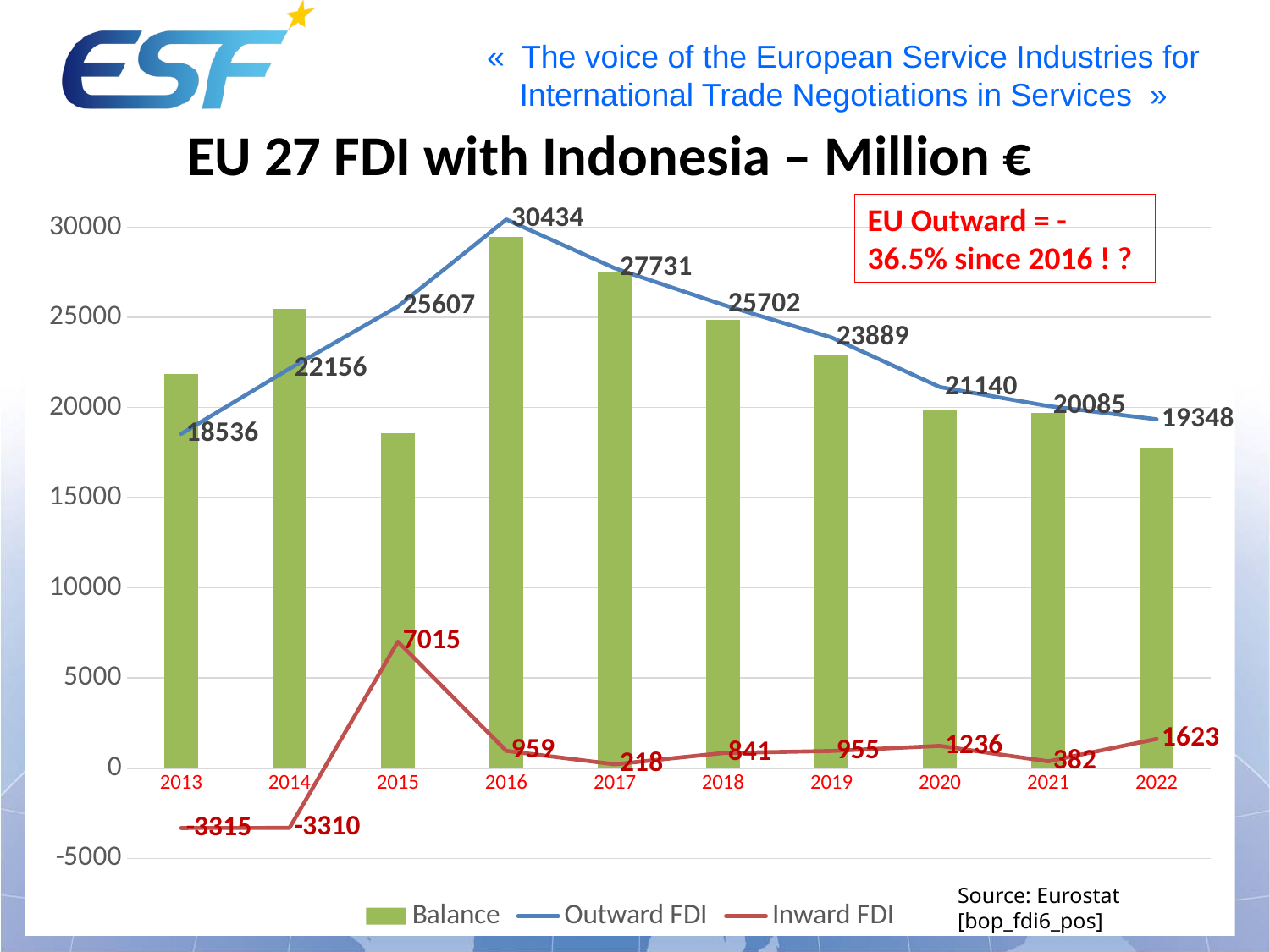
Is the Balance bar for 2016 greater or less than 25000? greater What is the difference between Outward FDI in 2016 and in 2022? 11086 How many series does the legend list? 3 How many years are shown on the x axis? 10 What is the Inward FDI value for 2013? -3315 Does Outward FDI rise or fall from 2016 to 2022? fall Is the Balance bar for 2015 greater or less than 20000? less In which year is Inward FDI lowest? 2013 Which is larger, Inward FDI in 2015 or Inward FDI in 2020? 2015 What is the Outward FDI value for 2016? 30434 In which year is Outward FDI highest? 2016 What is the Inward FDI value for 2022? 1623